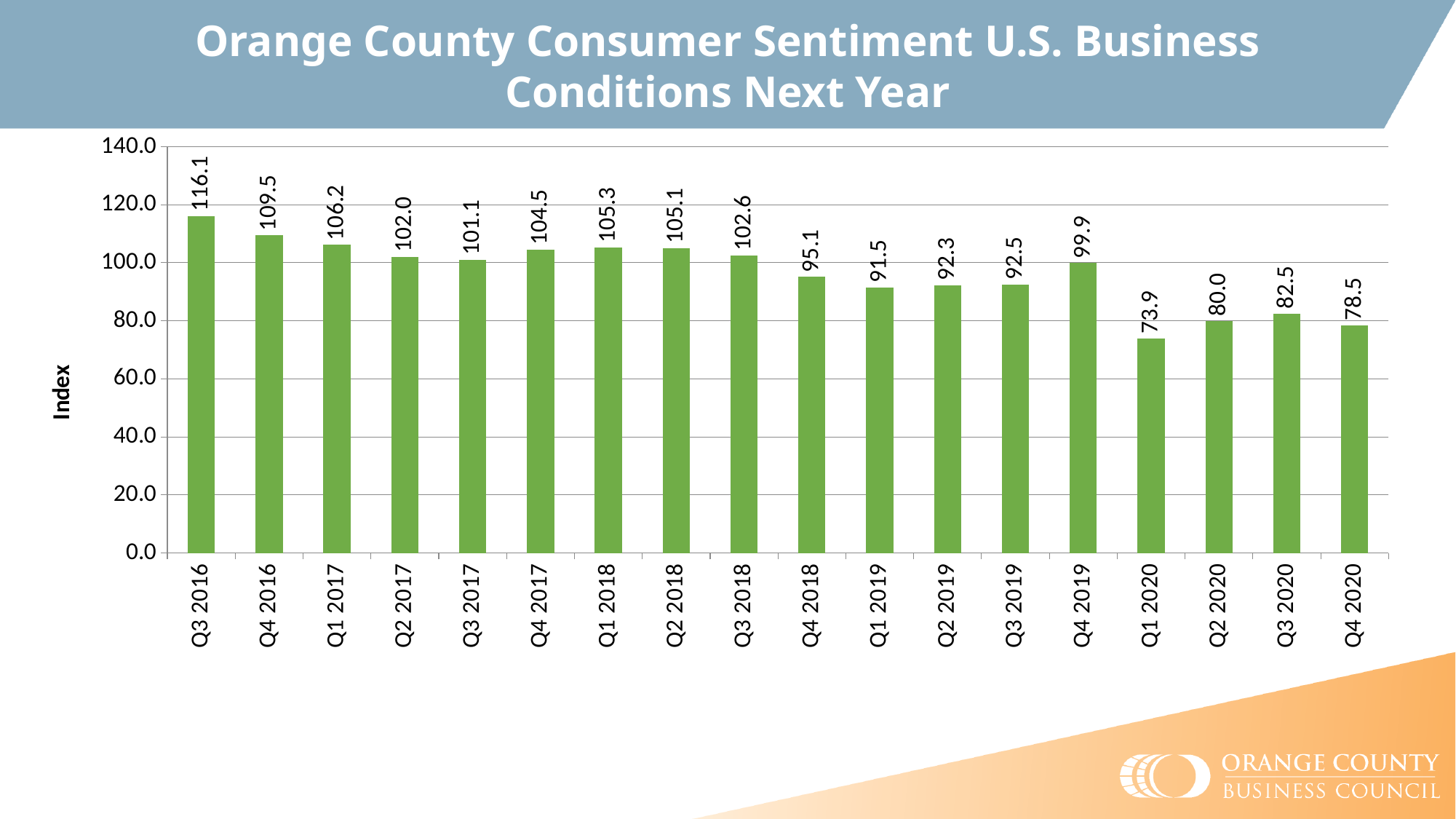
What is the index value for Q1 2020? 73.9 Do the index values generally rise or fall from Q3 2016 to Q4 2020? Fall How many quarters are shown on the chart? 18 Which is larger, the index value for Q3 2020 or Q4 2020? Q3 2020 Which quarter has the lowest index value? Q1 2020 What is the index value for Q4 2019? 99.9 What is the difference between the index values for Q3 2016 and Q4 2020? 37.6 What is the index value for Q3 2016? 116.1 Is the value for Q2 2019 greater or less than 100.0? less What kind of chart is shown on the slide? Bar chart What is the label on the vertical axis of the chart? Index Which quarter has the highest index value? Q3 2016